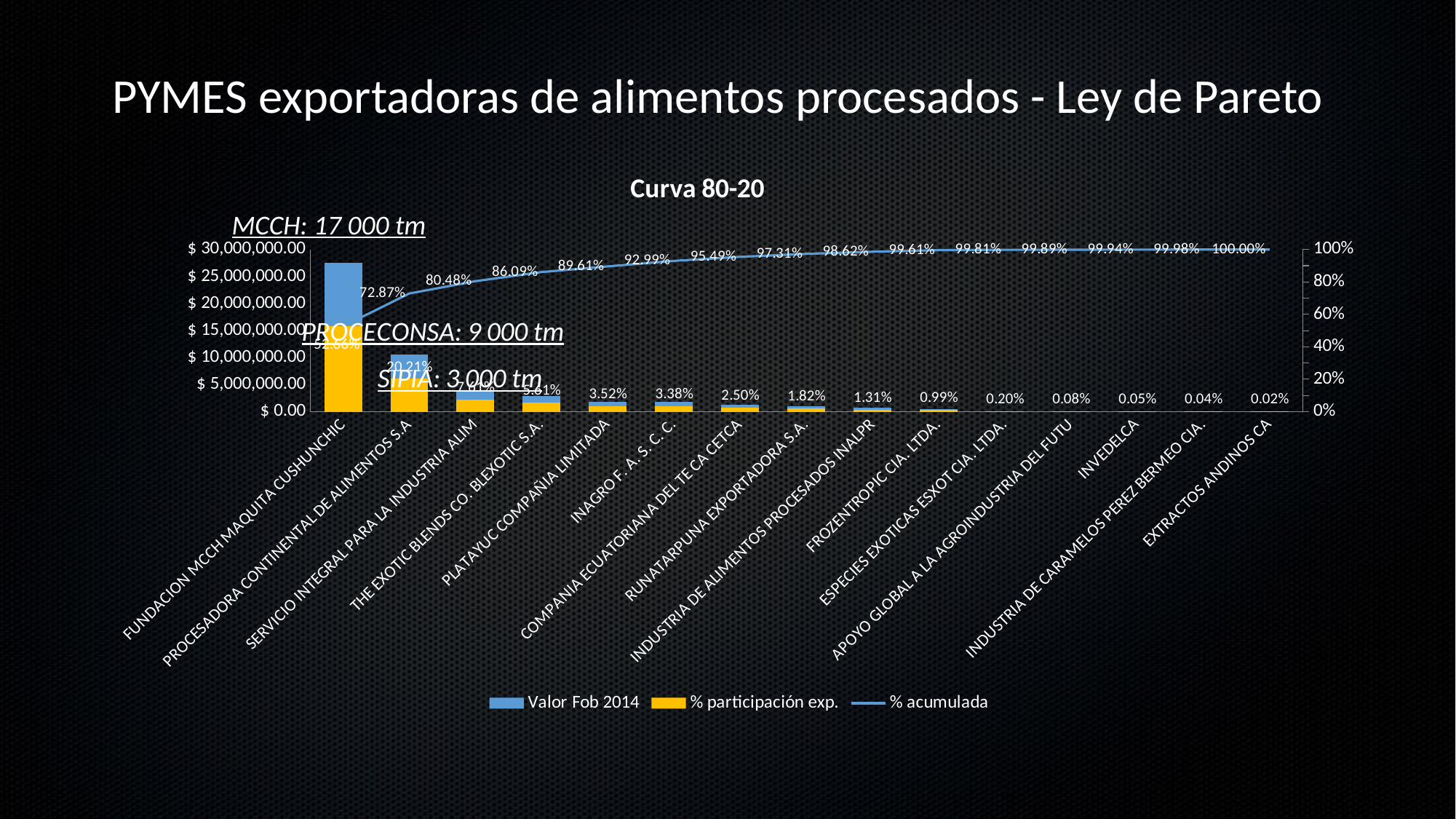
What is the cumulative percentage (% acumulada) shown for PROCESADORA CONTINENTAL DE ALIMENTOS S.A? 72.87% Is the Valor Fob 2014 for FUNDACION MCCH MAQUITA CUSHUNCHIC greater or less than $ 25,000,000.00? greater How many series does the legend list? 3 Which company has the lowest % participación exp.? EXTRACTOS ANDINOS CA Does the % acumulada line rise or fall from left to right along the x axis? rise What is the % participación exp. value shown for THE EXOTIC BLENDS CO. BLEXOTIC S.A.? 5.61% What is the % participación exp. value shown for INVEDELCA? 0.05% What is the difference between the % participación exp. of PLATAYUC COMPAÑIA LIMITADA and INAGRO F. A. S. C. C.? 0.14% Which has a larger % participación exp., RUNATARPUNA EXPORTADORA S.A. or FROZENTROPIC CIA. LTDA.? RUNATARPUNA EXPORTADORA S.A. Which company has the highest Valor Fob 2014? FUNDACION MCCH MAQUITA CUSHUNCHIC What is the cumulative percentage shown for EXTRACTOS ANDINOS CA? 100.00% How many companies are shown on the x axis of the chart? 15